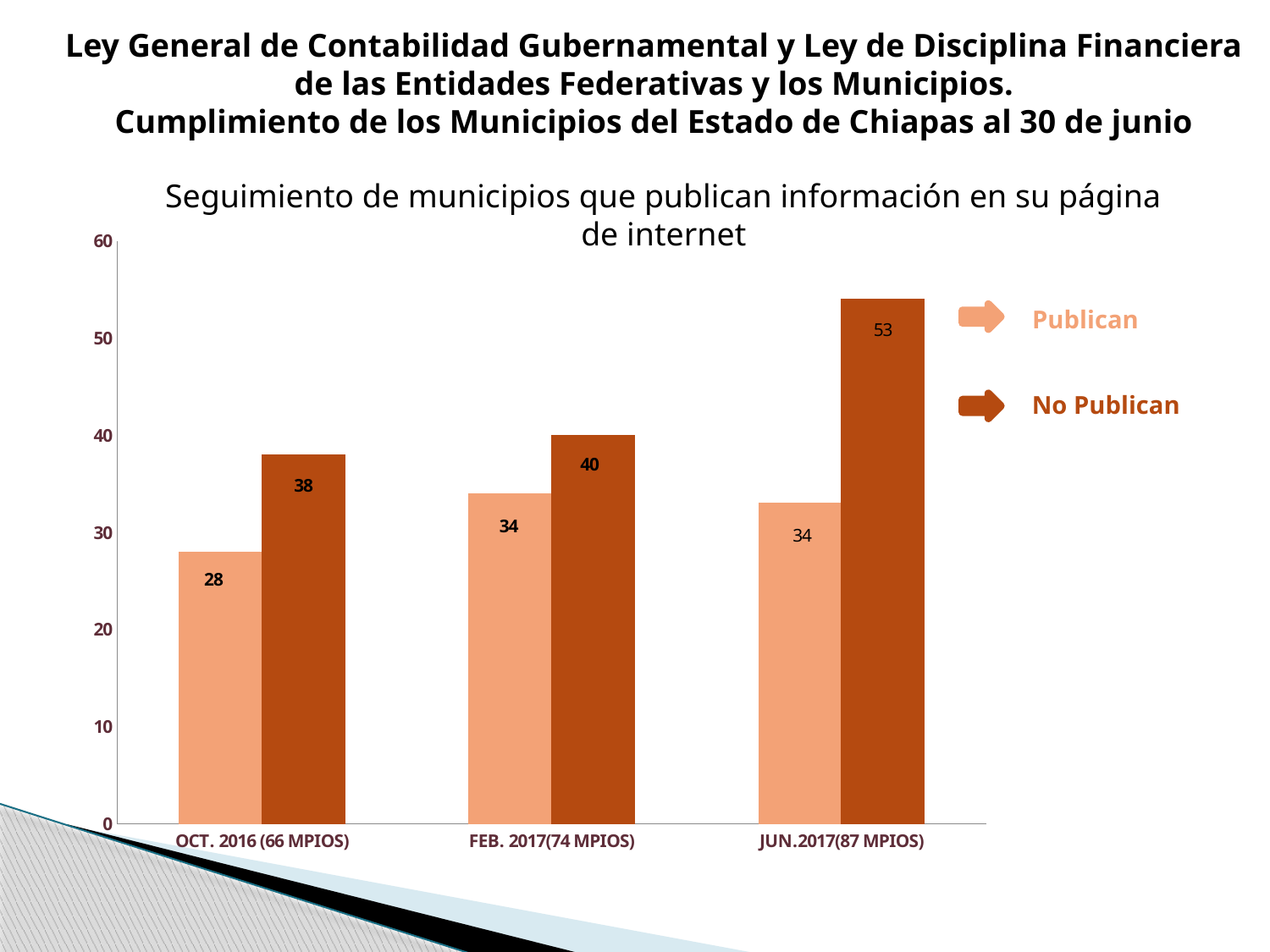
What is the value for Publican in FEB. 2017(74 MPIOS)? 34 What is the difference between No Publican and Publican in JUN.2017(87 MPIOS)? 19 What is the value for No Publican in FEB. 2017(74 MPIOS)? 40 What is the difference between No Publican and Publican in OCT. 2016 (66 MPIOS)? 10 How many series does the legend list? 2 What is the value for Publican in OCT. 2016 (66 MPIOS)? 28 In which period is the Publican value lowest? OCT. 2016 (66 MPIOS) In which period is the No Publican value highest? JUN.2017(87 MPIOS) What kind of chart is shown on the slide? Bar chart How many periods are shown on the x axis? 3 Which is larger in FEB. 2017(74 MPIOS), Publican or No Publican? No Publican What is the value for No Publican in JUN.2017(87 MPIOS)? 53